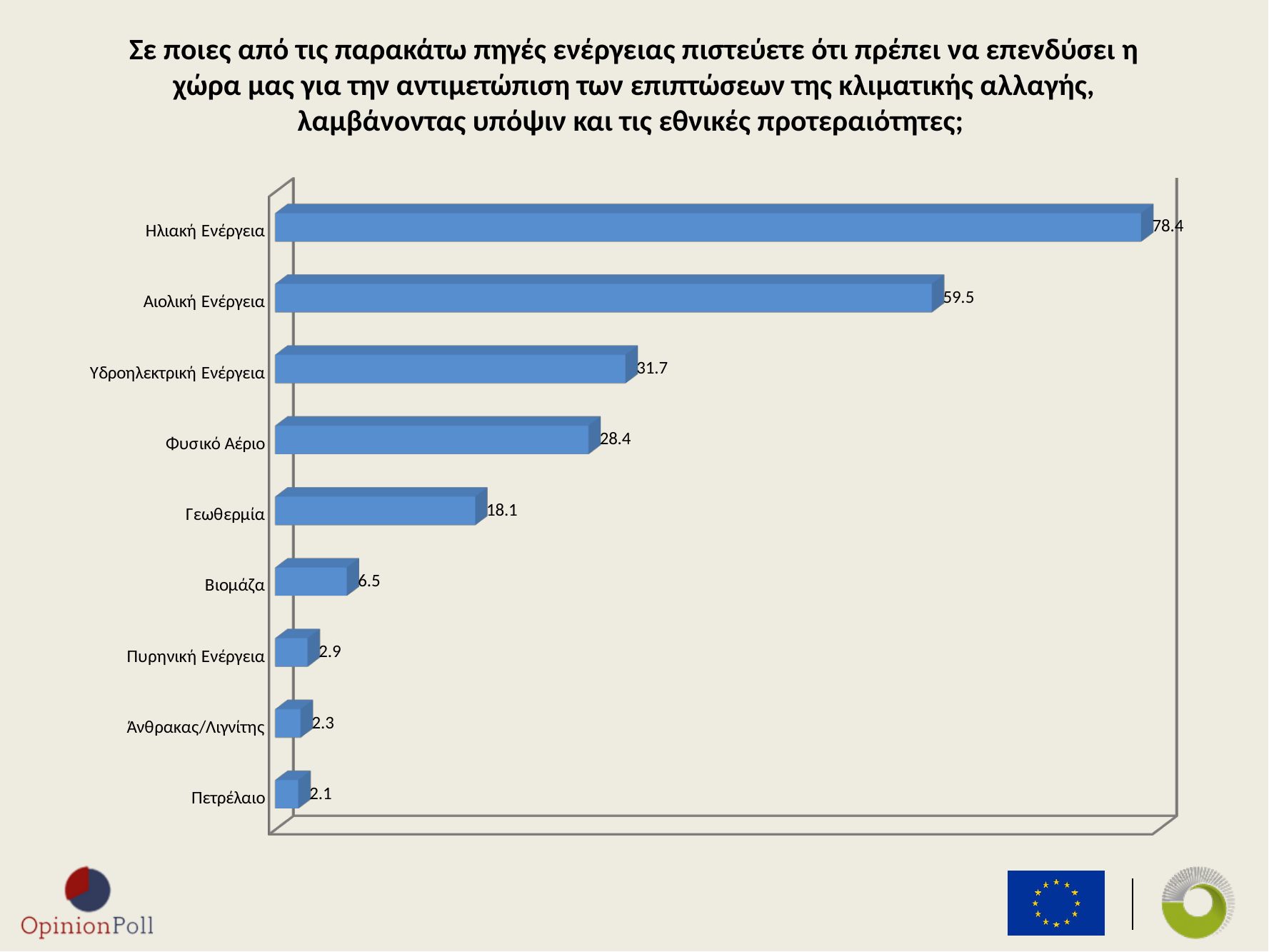
What is the difference between the values for Φυσικό Αέριο and Γεωθερμία? 10.3 What is the value for Υδροηλεκτρική Ενέργεια? 31.7 Which category has the highest value? Ηλιακή Ενέργεια What kind of chart is shown on the slide? Bar chart What is the value for Ηλιακή Ενέργεια? 78.4 Which category has the lowest value? Πετρέλαιο What colour are the bars in the chart? Blue Which is larger, the value for Υδροηλεκτρική Ενέργεια or the value for Φυσικό Αέριο? Υδροηλεκτρική Ενέργεια What is the difference between the values for Ηλιακή Ενέργεια and Αιολική Ενέργεια? 18.9 What is the value for Άνθρακας/Λιγνίτης? 2.3 What is the value for Γεωθερμία? 18.1 How many categories are shown in the chart? 9